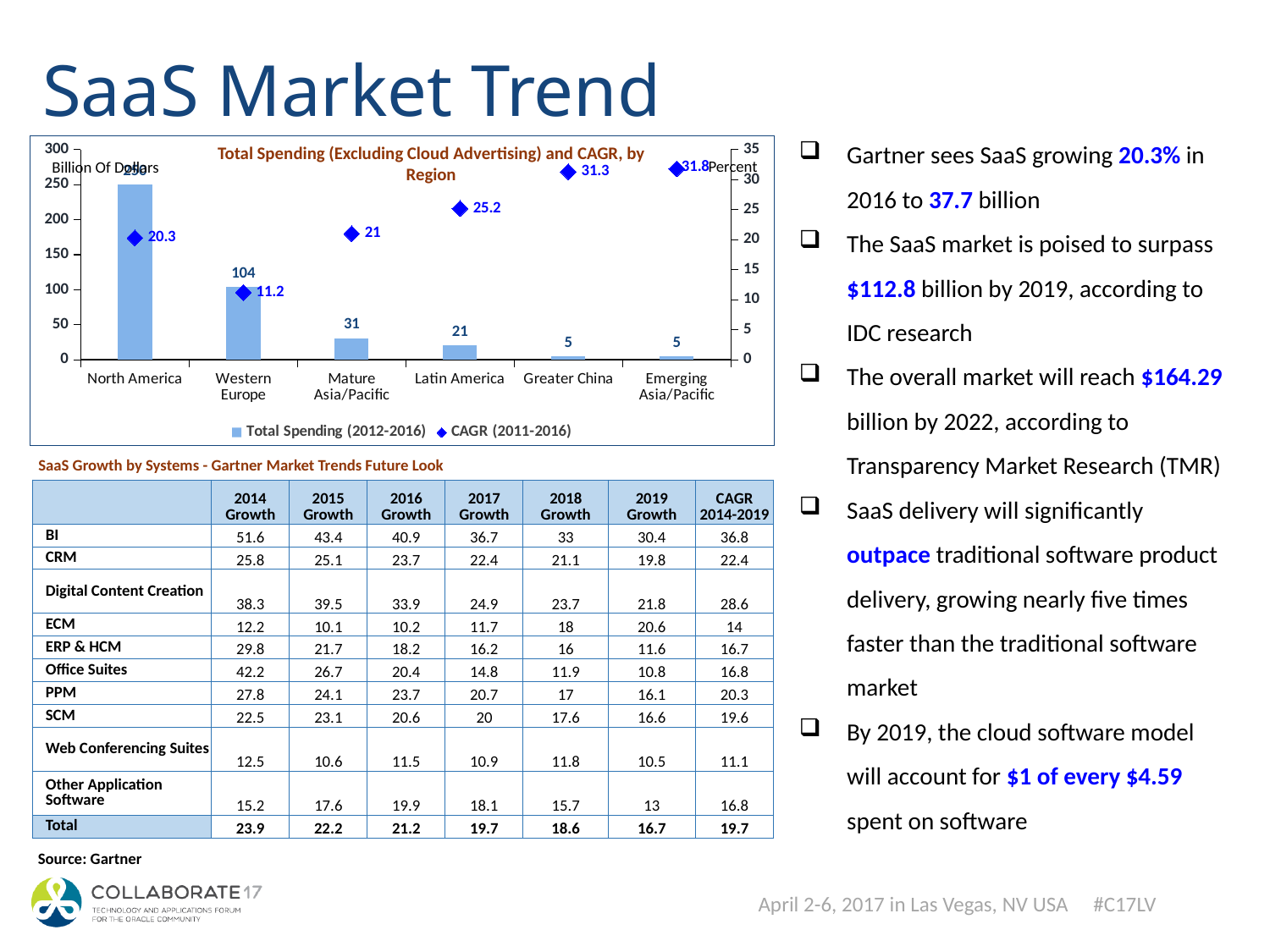
In the 'Total Spending (Excluding Cloud Advertising) and CAGR, by Region' chart, which region has the highest CAGR (2011-2016)? Emerging Asia/Pacific In the 'Total Spending (Excluding Cloud Advertising) and CAGR, by Region' chart, which has the higher CAGR (2011-2016): North America or Mature Asia/Pacific? Mature Asia/Pacific In the 'Total Spending (Excluding Cloud Advertising) and CAGR, by Region' chart, which region has the lowest CAGR (2011-2016)? Western Europe What kind of chart is used to show Total Spending (2012-2016) in the 'Total Spending (Excluding Cloud Advertising) and CAGR, by Region' chart? bar chart How many series does the legend of the 'Total Spending (Excluding Cloud Advertising) and CAGR, by Region' chart list? 2 In the 'Total Spending (Excluding Cloud Advertising) and CAGR, by Region' chart, which region has the highest Total Spending (2012-2016)? North America In the 'Total Spending (Excluding Cloud Advertising) and CAGR, by Region' chart, what is the CAGR (2011-2016) for Latin America? 25.2 In the 'Total Spending (Excluding Cloud Advertising) and CAGR, by Region' chart, what is the difference in Total Spending (2012-2016) between Western Europe and Mature Asia/Pacific? 73 How many regions are shown on the x axis of the 'Total Spending (Excluding Cloud Advertising) and CAGR, by Region' chart? 6 In the 'Total Spending (Excluding Cloud Advertising) and CAGR, by Region' chart, what is the Total Spending (2012-2016) value for Western Europe? 104 In the 'Total Spending (Excluding Cloud Advertising) and CAGR, by Region' chart, what is the Total Spending (2012-2016) value for Mature Asia/Pacific? 31 In the 'Total Spending (Excluding Cloud Advertising) and CAGR, by Region' chart, what is the CAGR (2011-2016) for Emerging Asia/Pacific? 31.8